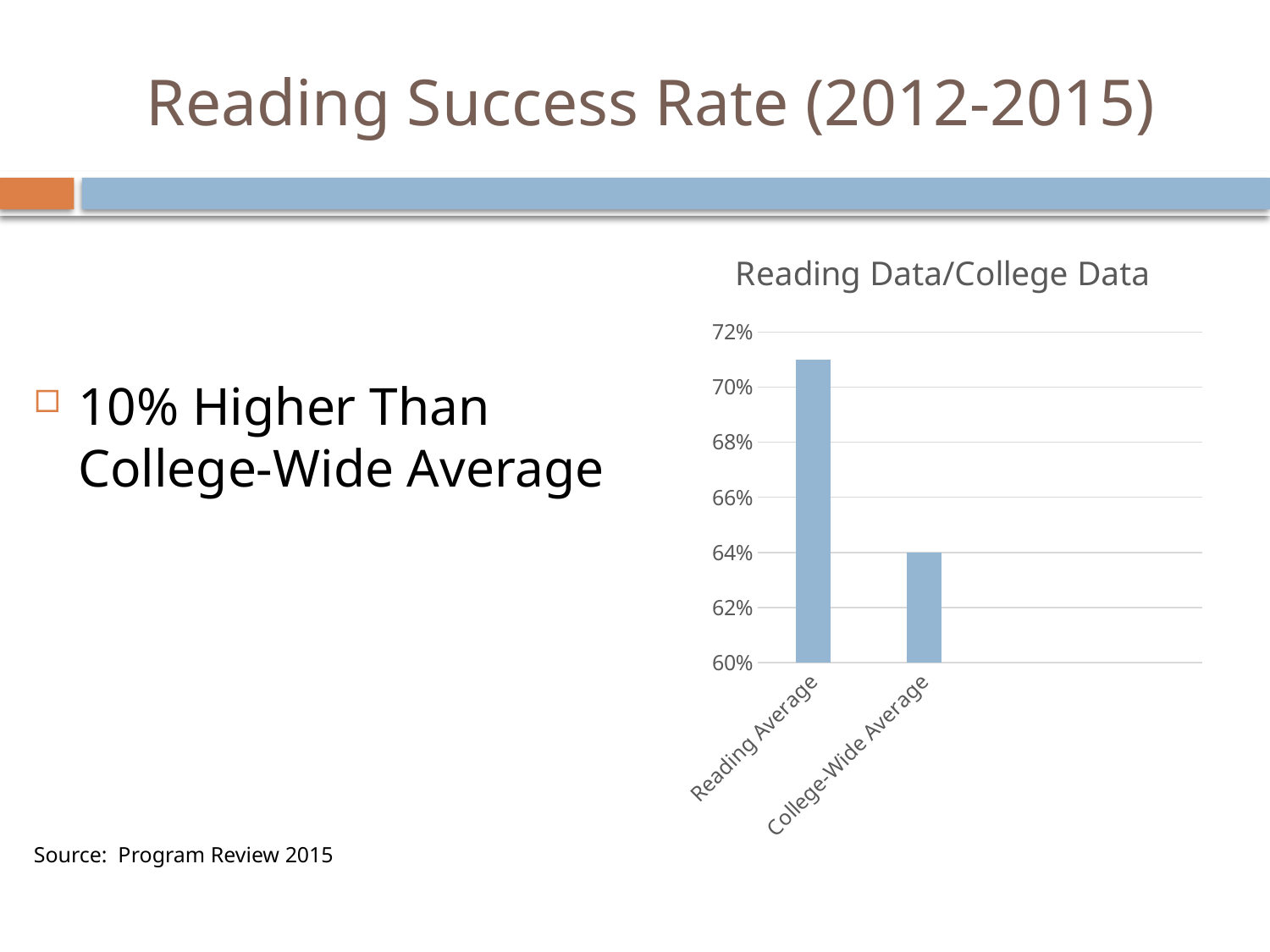
Do the values fall or rise from Reading Average to College-Wide Average along the x axis? fall What is the title of the chart? Reading Data/College Data What is the lowest value shown on the vertical axis? 60% How many bars are plotted in the chart? 2 Which category has the highest value? Reading Average Is the value for College-Wide Average greater or less than 66%? less What is the value for College-Wide Average? 64% Which category has the lowest value? College-Wide Average Which is larger, Reading Average or College-Wide Average? Reading Average Is the value for Reading Average greater or less than 70%? greater What type of chart is shown on the slide? bar chart Is the value for Reading Average greater or less than 72%? less